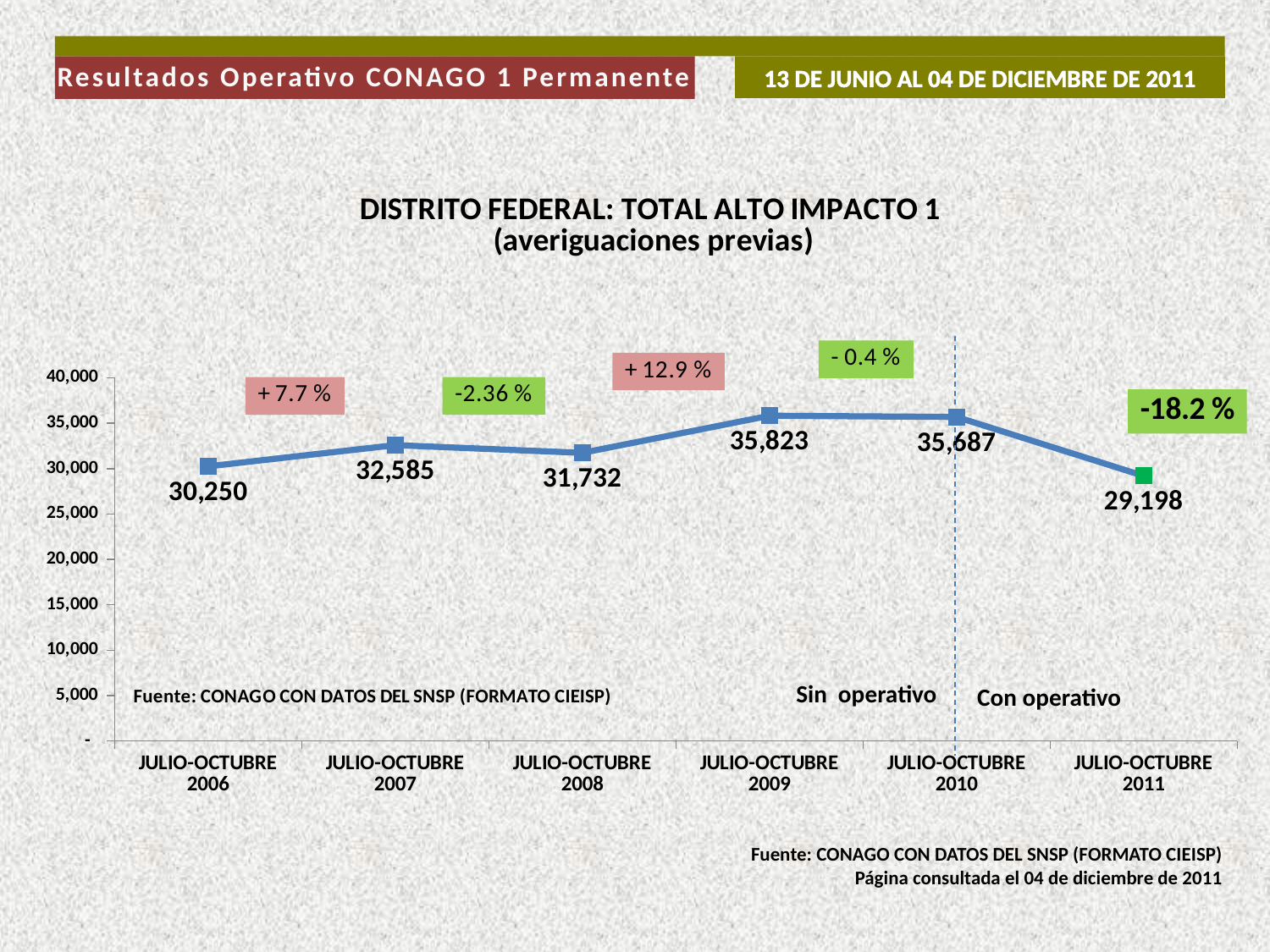
Which is larger, the value for JULIO-OCTUBRE 2007 or JULIO-OCTUBRE 2008? JULIO-OCTUBRE 2007 How many periods are plotted on the chart? 6 Is the value for JULIO-OCTUBRE 2008 greater or less than 35,000? less What is the value for JULIO-OCTUBRE 2009? 35,823 What is the value for JULIO-OCTUBRE 2011? 29,198 What kind of chart is shown on the slide? line chart What percentage change is labelled between JULIO-OCTUBRE 2010 and JULIO-OCTUBRE 2011? -18.2 % What is the difference between the values for JULIO-OCTUBRE 2010 and JULIO-OCTUBRE 2011? 6,489 Which period has the lowest value? JULIO-OCTUBRE 2011 Does the value rise or fall from JULIO-OCTUBRE 2010 to JULIO-OCTUBRE 2011? fall What is the value for JULIO-OCTUBRE 2006? 30,250 Which period has the highest value? JULIO-OCTUBRE 2009